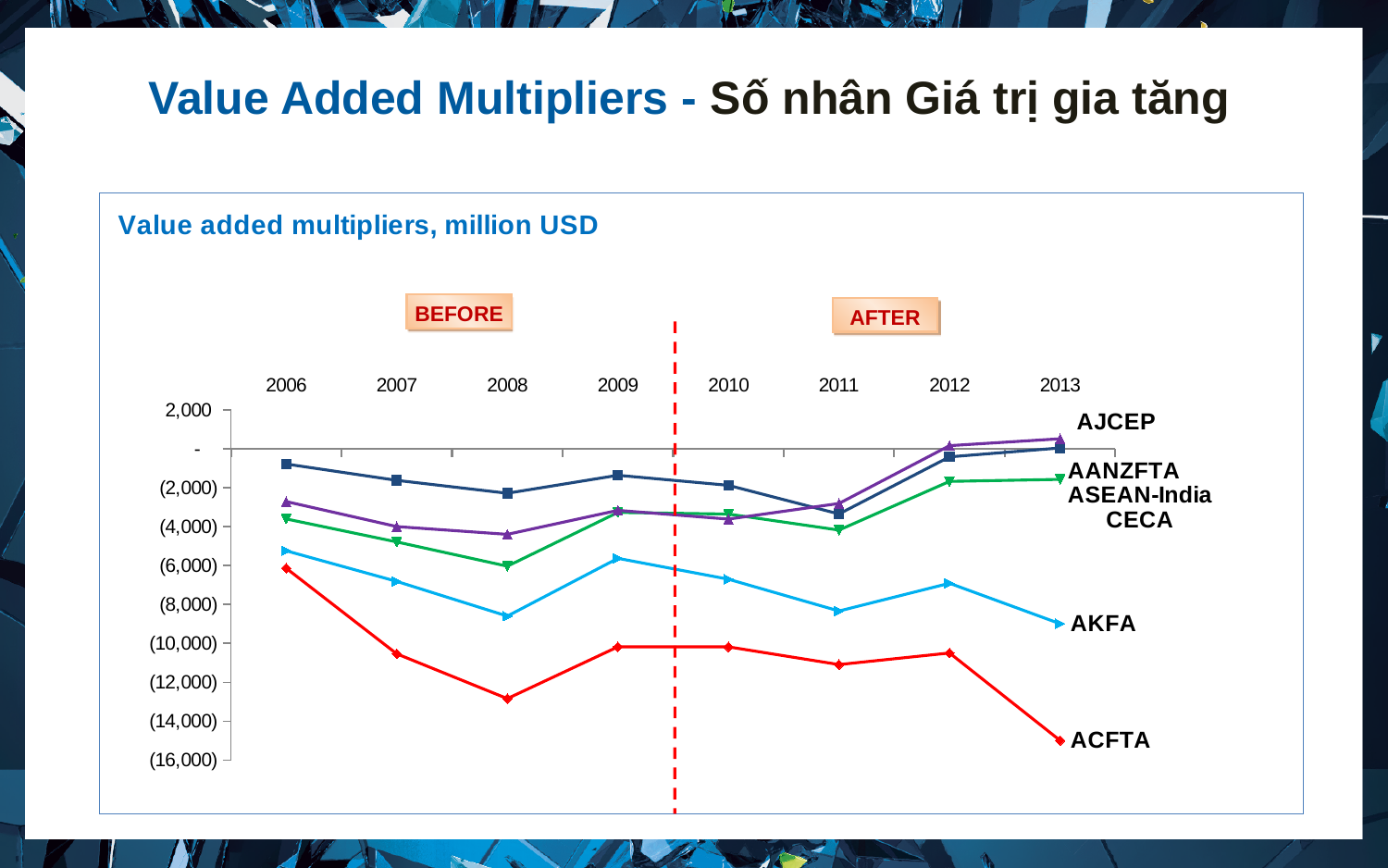
Which series has the lowest value in 2008? ACFTA Is the value for AKFA in 2006 greater or less than (6,000)? greater Does the ACFTA line rise or fall from 2012 to 2013? fall Which series has the highest value in 2013? AJCEP Is the value for ACFTA in 2013 greater or less than (14,000)? less How many years are plotted along the x axis? 8 How many series (agreements) are plotted on the chart? 5 Is the value for ACFTA in 2007 greater or less than (10,000)? less What kind of chart is shown on the slide? line chart In 2013, which is larger: the value for AKFA or the value for ACFTA? AKFA What is the title of the chart? Value added multipliers, million USD Does the AKFA line rise or fall from 2006 to 2008? fall